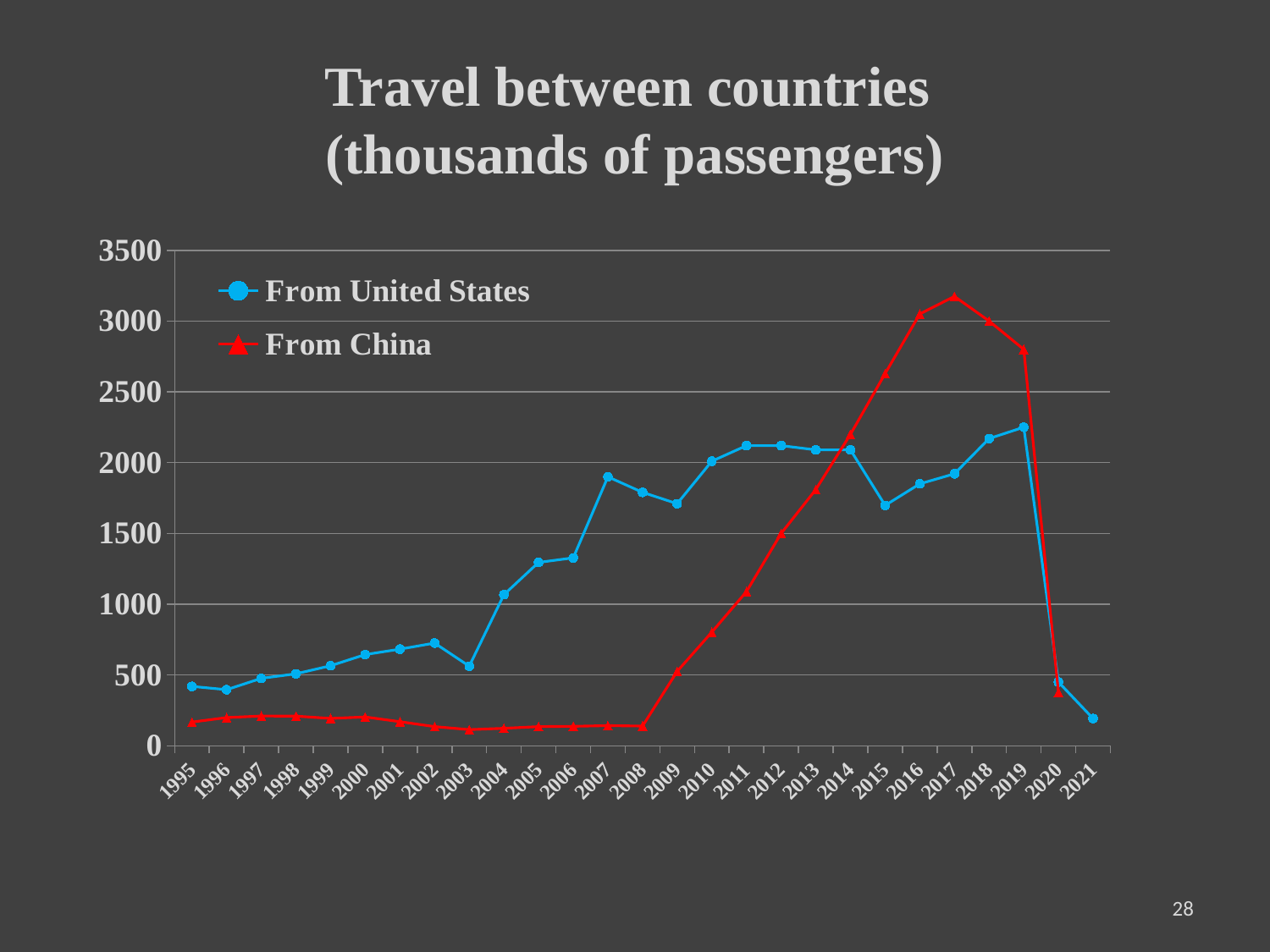
In 2017, which series has the larger value, From United States or From China? From China How many years are plotted along the x axis? 27 Does the From China series rise or fall between 2008 and 2017? rise In which year does the From United States series reach its highest value? 2019 How many series does the legend list? 2 In which year does the From United States series reach its lowest value? 2021 What kind of chart is shown on the slide? line chart In which year does the From China series reach its highest value? 2017 Is the From China value for 2008 greater or less than 500? less Is the From China value for 2017 greater or less than 3000? greater In 2007, which series has the larger value, From United States or From China? From United States Is the From United States value for 2007 greater or less than 1500? greater